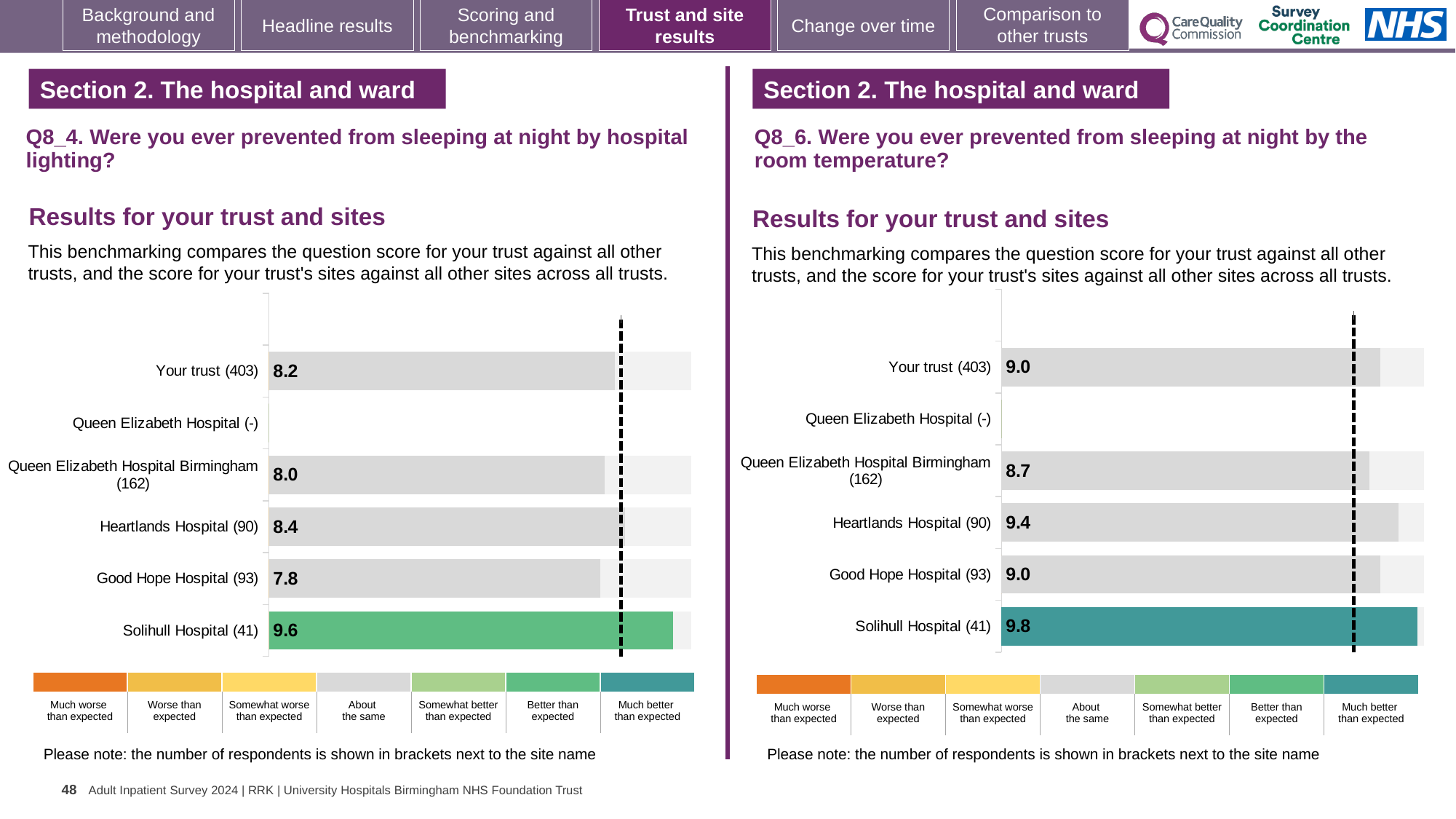
On the Q8_4 hospital lighting chart, what is the difference between the scores for Solihull Hospital (41) and Good Hope Hospital (93)? 1.8 On the Q8_6 room temperature chart, what is the difference between the scores for Heartlands Hospital (90) and Your trust (403)? 0.4 On the Q8_4 hospital lighting chart, which site has the highest score? Solihull Hospital (41) On the Q8_6 room temperature chart, what is the score for Solihull Hospital (41)? 9.8 On the Q8_4 hospital lighting chart, what is the score for Your trust (403)? 8.2 How many categories are listed on the vertical axis of the Q8_6 room temperature chart? 6 What kind of chart is used on the Q8_4 hospital lighting side of the slide? Bar chart On the Q8_4 hospital lighting chart, what is the score for Good Hope Hospital (93)? 7.8 On the Q8_6 room temperature chart, which site has the lowest score? Queen Elizabeth Hospital Birmingham (162) On the Q8_4 hospital lighting chart, which site has the lowest score? Good Hope Hospital (93) On the Q8_4 hospital lighting chart, which has the higher score: Heartlands Hospital (90) or Queen Elizabeth Hospital Birmingham (162)? Heartlands Hospital (90) On the Q8_6 room temperature chart, what is the score for Queen Elizabeth Hospital Birmingham (162)? 8.7